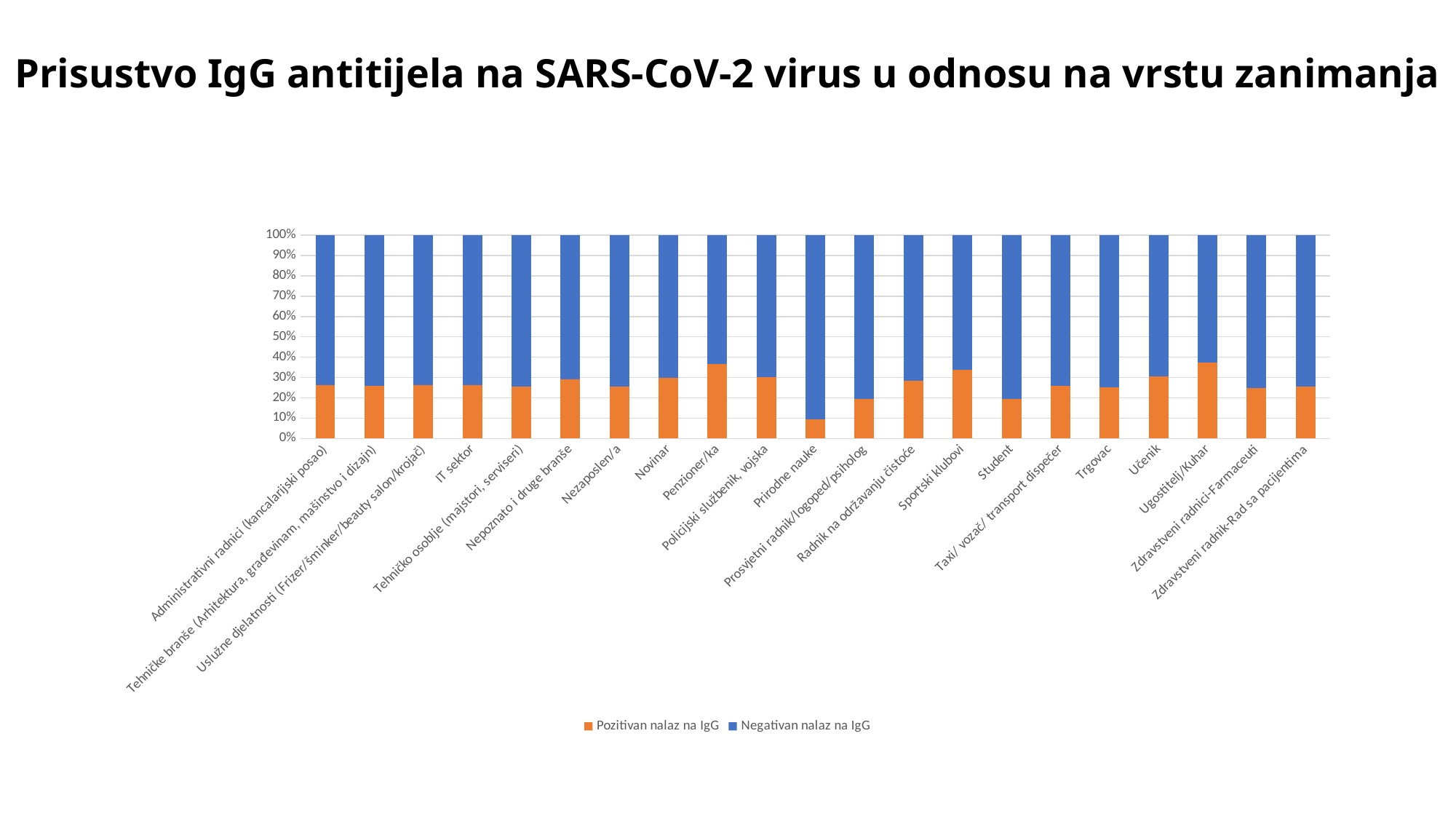
What kind of chart is shown on the slide? Stacked bar chart Is the 'Pozitivan nalaz na IgG' share for Penzioner/ka greater or less than 30%? greater How many series does the legend list? 2 How many occupation categories are plotted on the x axis? 21 Which has a larger 'Pozitivan nalaz na IgG' share: Penzioner/ka or Prirodne nauke? Penzioner/ka Is the 'Negativan nalaz na IgG' share for Prirodne nauke greater or less than 80%? greater Which series is shown in orange? Pozitivan nalaz na IgG Which has a larger 'Pozitivan nalaz na IgG' share: Sportski klubovi or Student? Sportski klubovi Is the 'Pozitivan nalaz na IgG' share for Ugostitelj/Kuhar greater or less than 30%? greater What is the title of the chart? Prisustvo IgG antitijela na SARS-CoV-2 virus u odnosu na vrstu zanimanja Which occupation category has the lowest share of 'Pozitivan nalaz na IgG'? Prirodne nauke